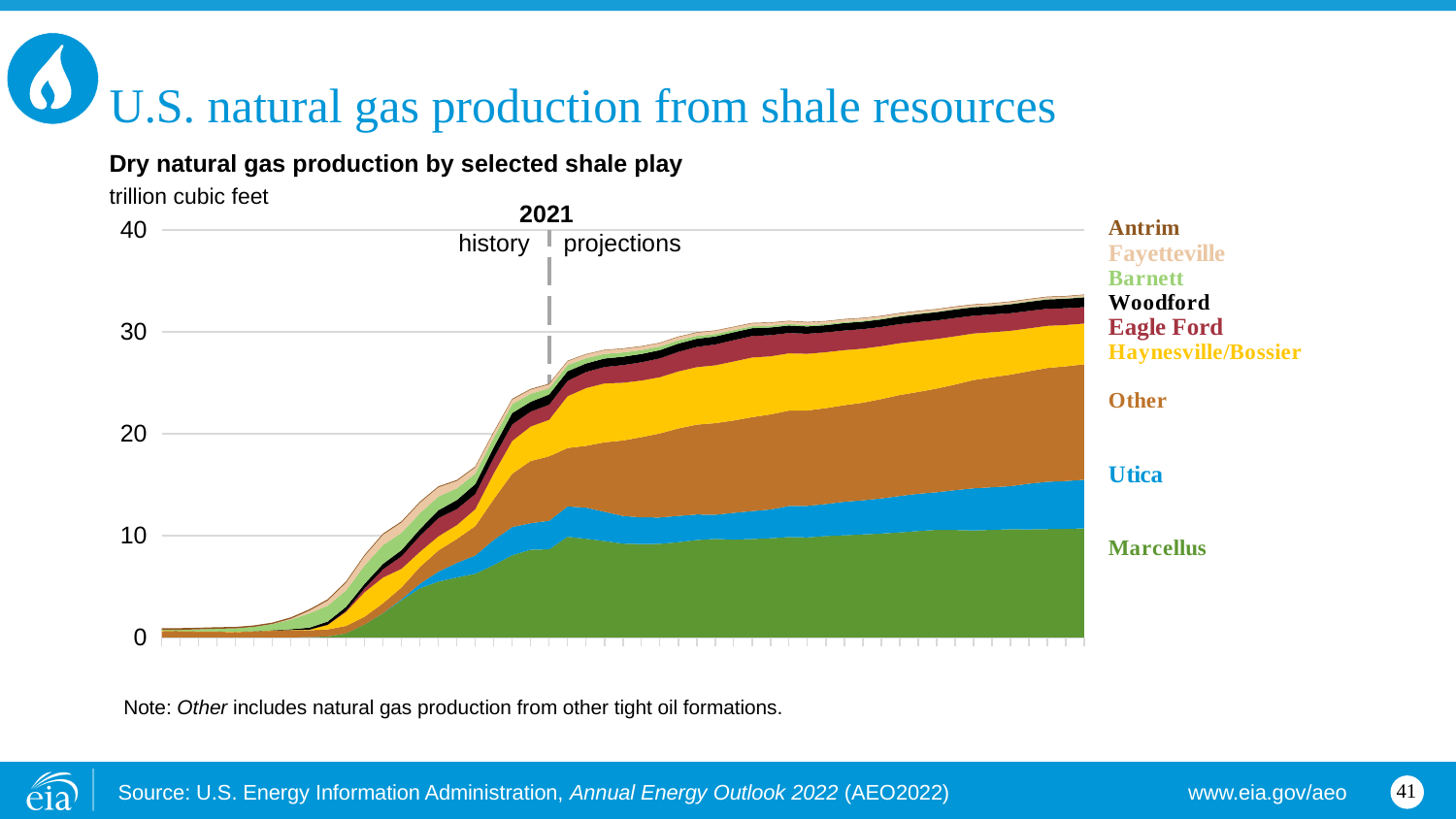
Which is larger at the end of the projection period, production from Other or from Haynesville/Bossier? Other Is the total dry natural gas production from shale in 2021 greater or less than 20 trillion cubic feet? greater Which year marks the boundary between history and projections on the chart? 2021 Is the total dry natural gas production from shale at the end of the projection period greater or less than 40 trillion cubic feet? less What kind of chart is shown on the slide? stacked area chart Is the total dry natural gas production from shale in 2021 greater or less than 30 trillion cubic feet? less Which is larger at the end of the projection period, production from Marcellus or from Utica? Marcellus Does total shale gas production generally rise or fall over the period shown? rise What unit is used on the y-axis of the chart? trillion cubic feet How many shale plays (series) does the legend list? 9